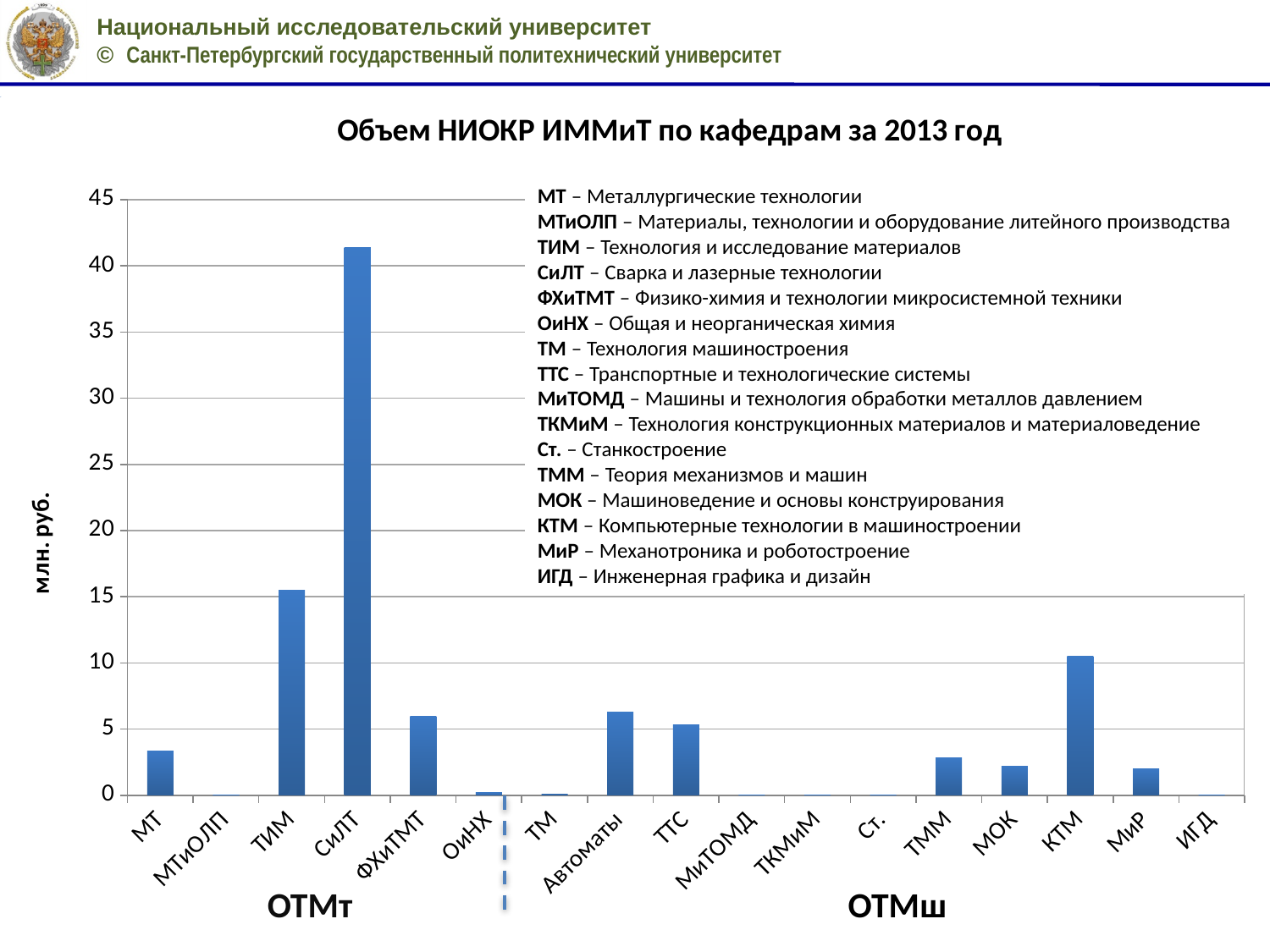
Is the value for КТМ greater or less than 10? greater What is the label of the vertical axis? млн. руб. How many departments (categories) are shown on the x axis? 17 Which is larger, the value for ТИМ or the value for КТМ? ТИМ Is the value for МТ greater or less than 5? less What is the title of the chart? Объем НИОКР ИММиТ по кафедрам за 2013 год Is the value for ТИМ greater or less than 15? greater Which department has the highest value in the chart? СиЛТ What kind of chart is shown on the slide? bar chart Which is larger, the value for ФХиТМТ or the value for МОК? ФХиТМТ